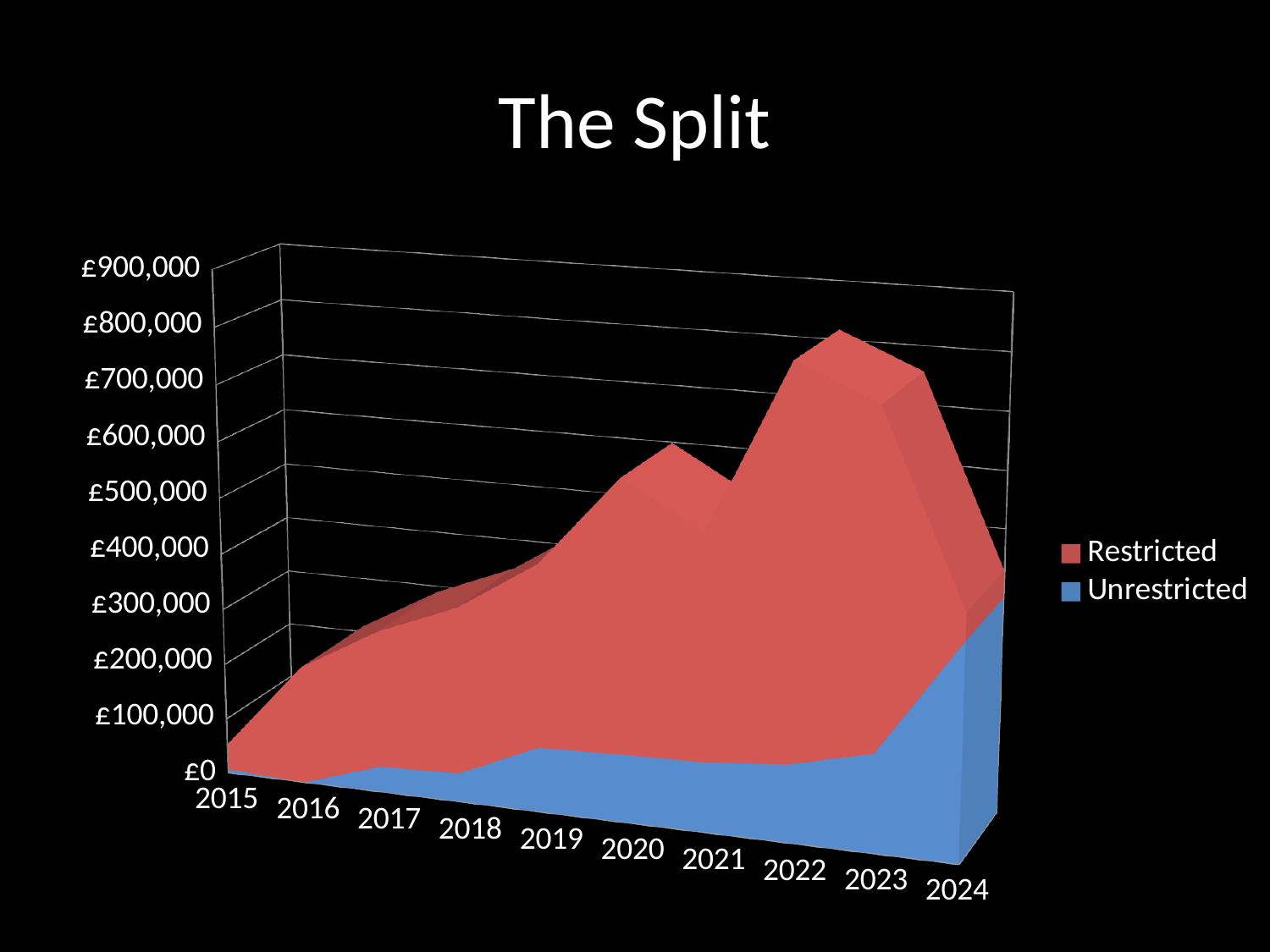
In which year is the combined total of Restricted and Unrestricted lowest? 2015 Is the Unrestricted value for 2018 greater or less than £100,000? less What is the title of the chart? The Split What kind of chart is shown on the slide? Area chart Which series is shown in blue? Unrestricted How many years are shown along the x axis? 10 In 2020, which series is larger, Restricted or Unrestricted? Restricted Is the combined Restricted and Unrestricted total for 2015 greater or less than £200,000? less Does the Unrestricted value rise or fall from 2021 to 2024? Rise How many series does the legend list? 2 In which year is the Unrestricted value highest? 2024 Is the combined Restricted and Unrestricted total for 2022 greater or less than £600,000? greater